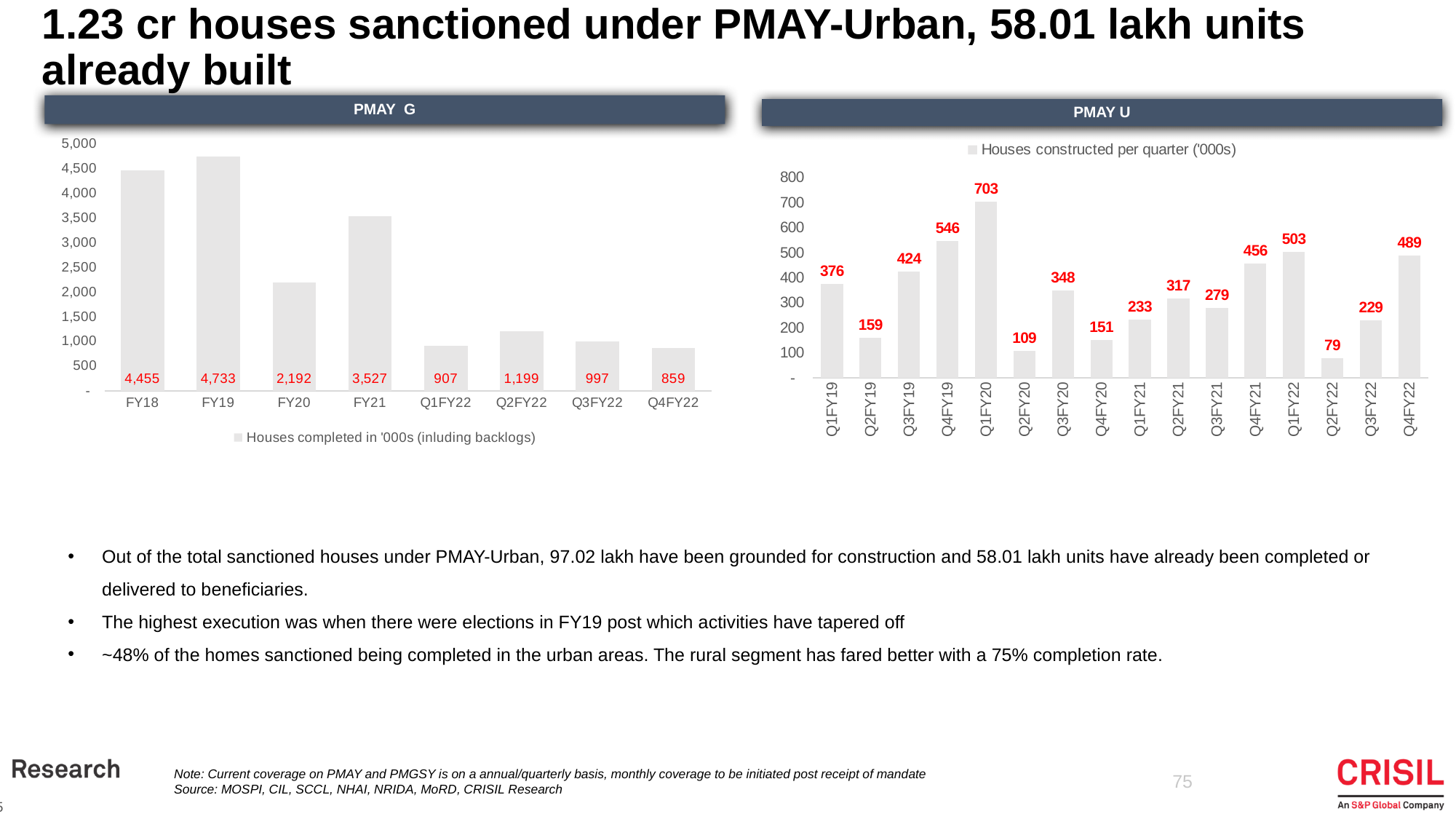
In the PMAY G chart, which is larger, Q2FY22 or Q3FY22? Q2FY22 What type of chart is the PMAY U chart? Bar chart What is the legend entry of the PMAY G chart? Houses completed in '000s (inluding backlogs) In the PMAY U chart, which quarter has the highest value? Q1FY20 In the PMAY G chart, which category has the lowest value? Q4FY22 In the PMAY U chart, what is the value for Q1FY20? 703 In the PMAY U chart, which quarter has the lowest value? Q2FY22 In the PMAY G chart, what is the difference between FY18 and FY20? 2,263 In the PMAY G chart, how many bars are plotted? 8 In the PMAY U chart, how many quarters are plotted? 16 In the PMAY G chart, what is the value for FY19? 4,733 In the PMAY U chart, what is the difference between Q1FY22 and Q4FY22? 14